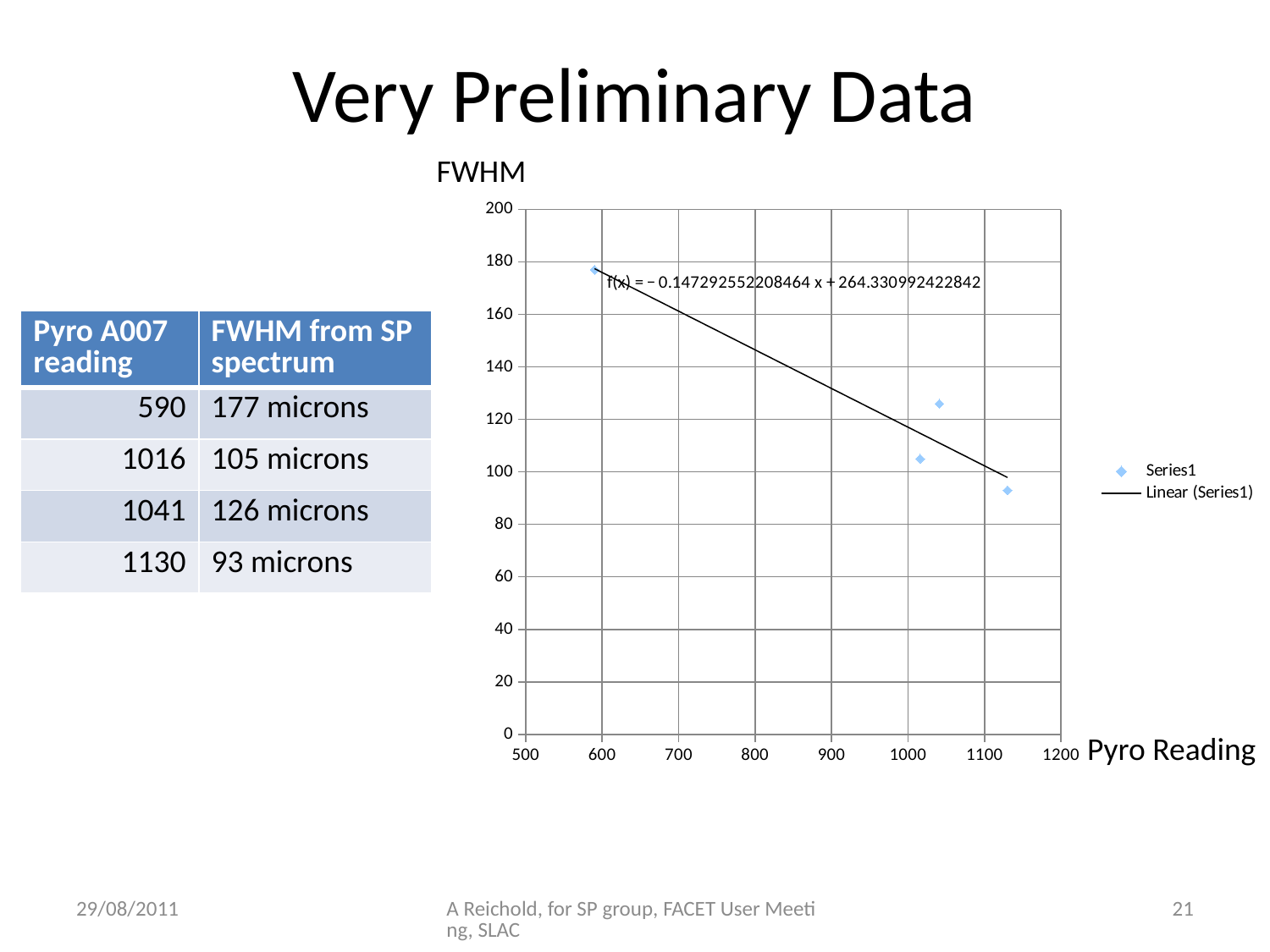
What is the FWHM value for the Pyro A007 reading of 590? 177 microns What is the FWHM value for the Pyro A007 reading of 1130? 93 microns What is the difference between the FWHM at reading 590 and the FWHM at reading 1130? 84 microns Do the plotted FWHM values generally rise or fall as the Pyro Reading increases? Fall Which Pyro A007 reading has the highest FWHM? 590 Which has the larger FWHM, the reading of 1016 or the reading of 1041? 1041 What is the label of the x axis of the chart? Pyro Reading What kind of chart is shown on the slide? Scatter chart How many entries does the chart legend list? 2 What is the title of the chart? FWHM Which Pyro A007 reading has the lowest FWHM? 1130 How many data points are plotted in the chart? 4